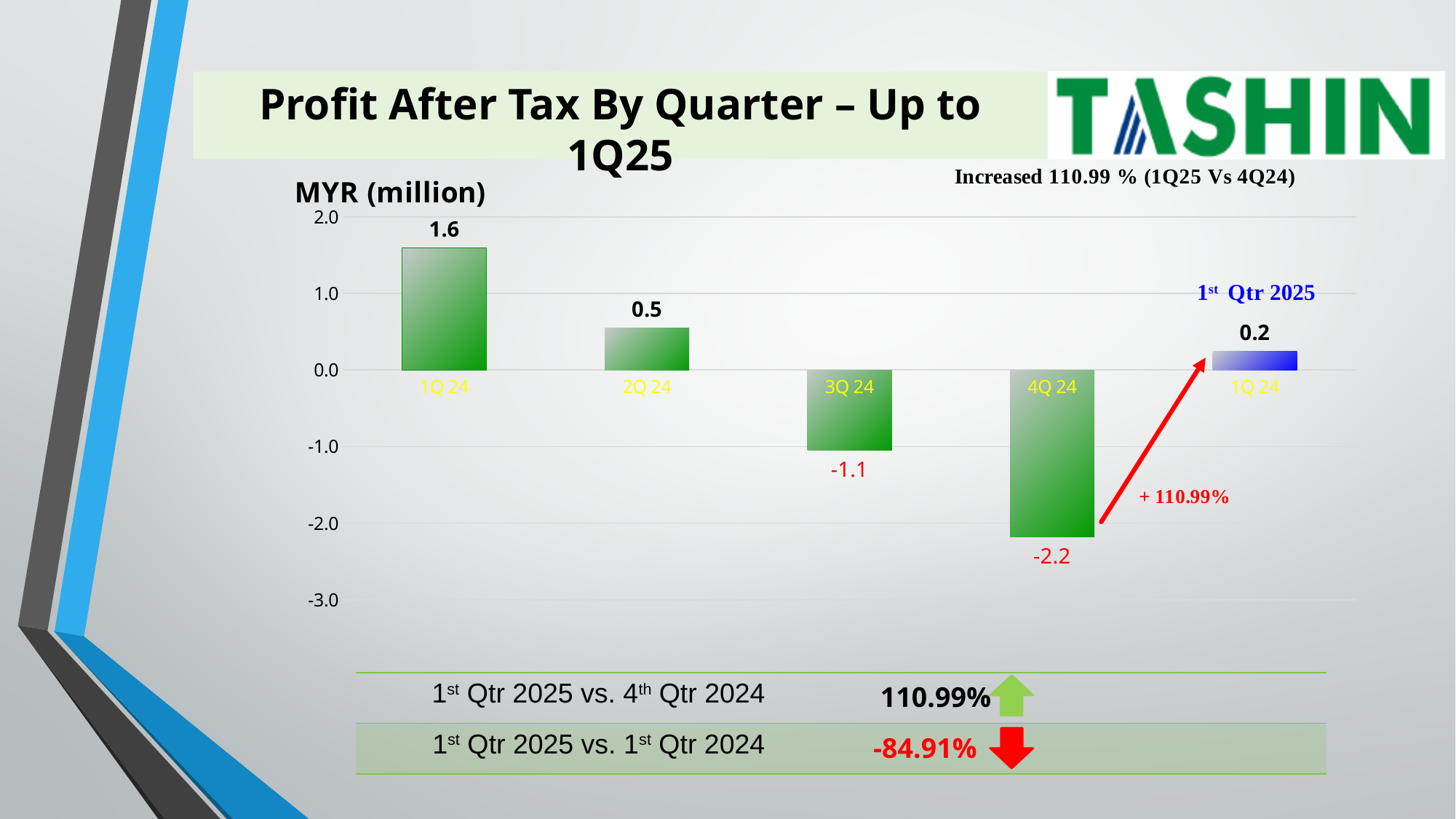
Which bar has the highest profit after tax in the chart? 1Q 24 (the first bar) What is the profit after tax value shown for 2Q 24? 0.5 What is the difference between the 1Q 24 value (1.6) and the 2Q 24 value (0.5)? 1.1 What is the profit after tax value shown for 1Q 24 (the first bar)? 1.6 What unit is stated for the values in the chart? MYR (million) How many bars are plotted in the chart? 5 What is the profit after tax value shown for 3Q 24? -1.1 Which is larger, the value for 3Q 24 or the value for 4Q 24? 3Q 24 What is the profit after tax value shown for 4Q 24? -2.2 Which quarter has the lowest profit after tax in the chart? 4Q 24 What type of chart is shown on the slide? Bar chart What is the value shown on the rightmost bar, annotated as 1st Qtr 2025? 0.2